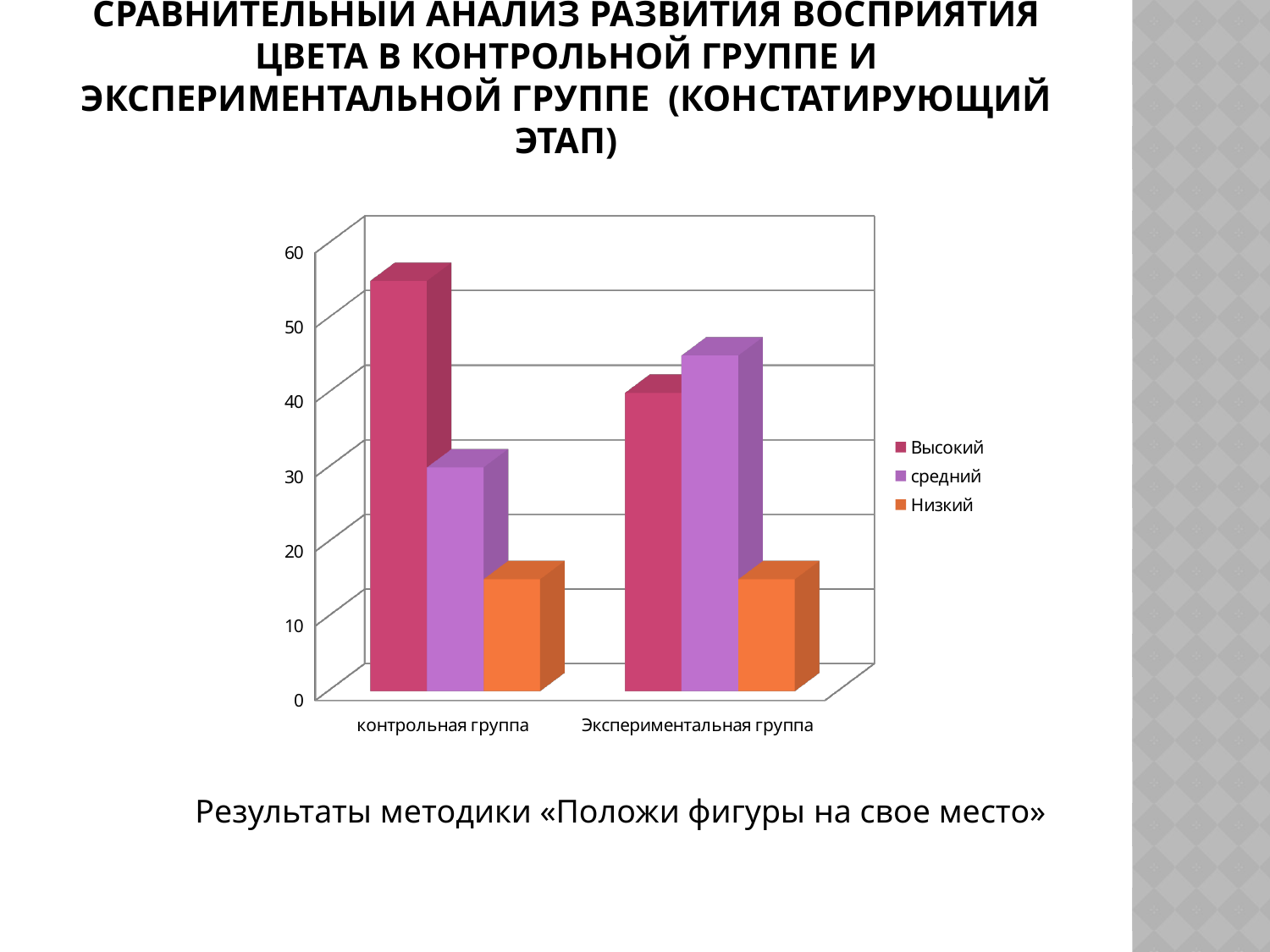
Which series is shown in orange in the legend? Низкий Is the value for Высокий in Экспериментальная группа greater or less than 30? greater How many groups (categories) are shown on the x axis? 2 Is the value for средний in Экспериментальная группа greater or less than 40? greater Which level has the highest value in контрольная группа? Высокий How many series does the legend list? 3 What kind of chart is shown on the slide? bar chart Is the value for Высокий in контрольная группа greater or less than 50? greater Which group has the larger value for Высокий: контрольная группа or Экспериментальная группа? контрольная группа Which group has the larger value for средний: контрольная группа or Экспериментальная группа? Экспериментальная группа